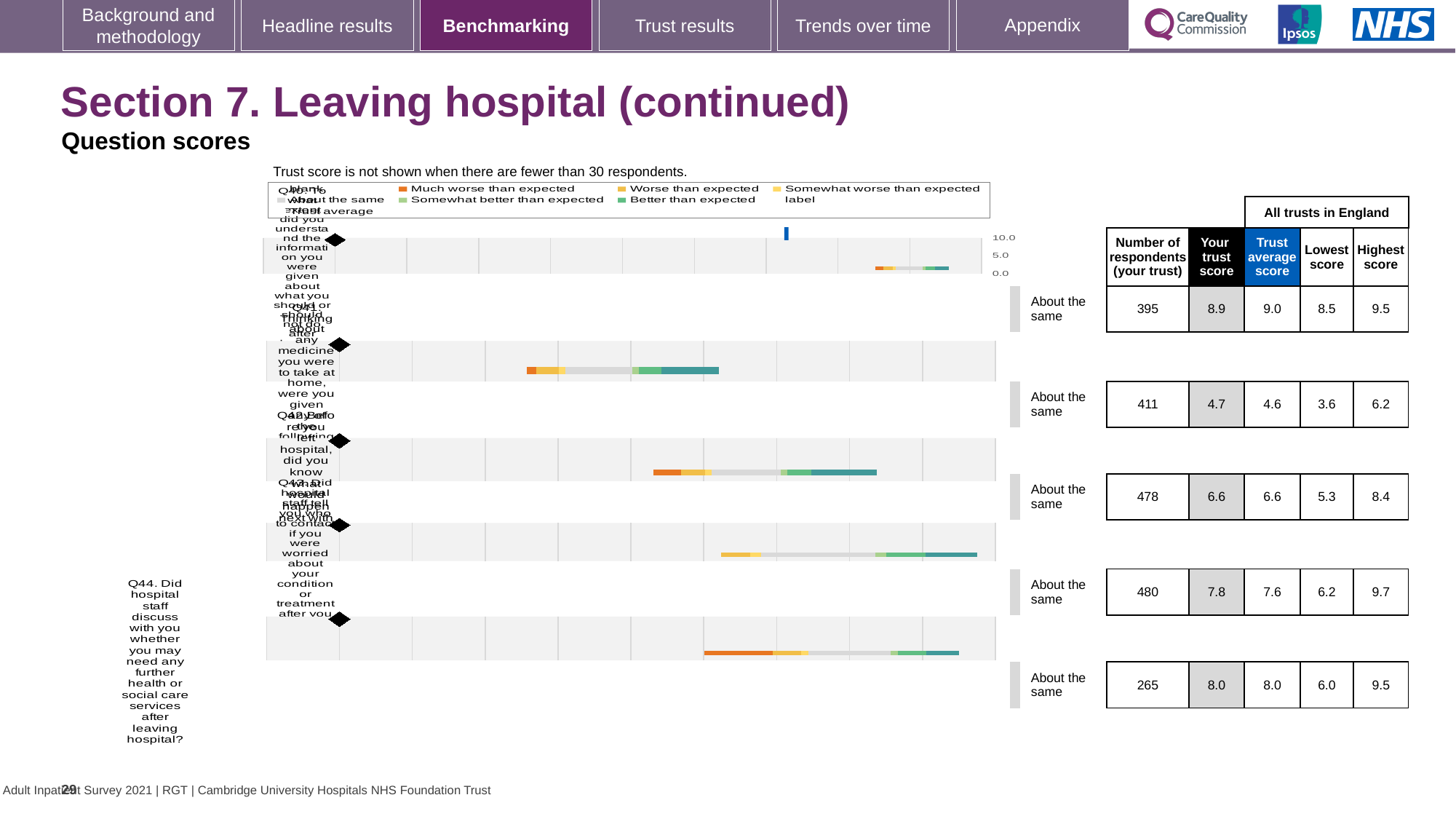
How many respondents (your trust) are shown for Q44? 265 What is the highest 'Your trust score' value shown in the table on this slide? 8.9 For Q44, what is the difference between the highest score (9.5) and the lowest score (6.0) across all trusts in England? 3.5 How many question rows are plotted on this slide? 5 According to the note above the chart, the trust score is not shown when there are fewer than how many respondents? 30 What is the lowest 'Your trust score' value shown in the table on this slide? 4.7 What kind of chart is used to show the question scores on this slide? Bar chart What is the lowest score across all trusts in England for Q44? 6.0 What benchmark category is shown for Q44? About the same For the first question row (395 respondents), which is larger: the 'Your trust score' or the 'Trust average score'? Trust average score (9.0) What is the highest score across all trusts in England for Q44? 9.5 What is the 'Your trust score' value for Q44 (discussing whether you may need further health or social care services after leaving hospital)? 8.0